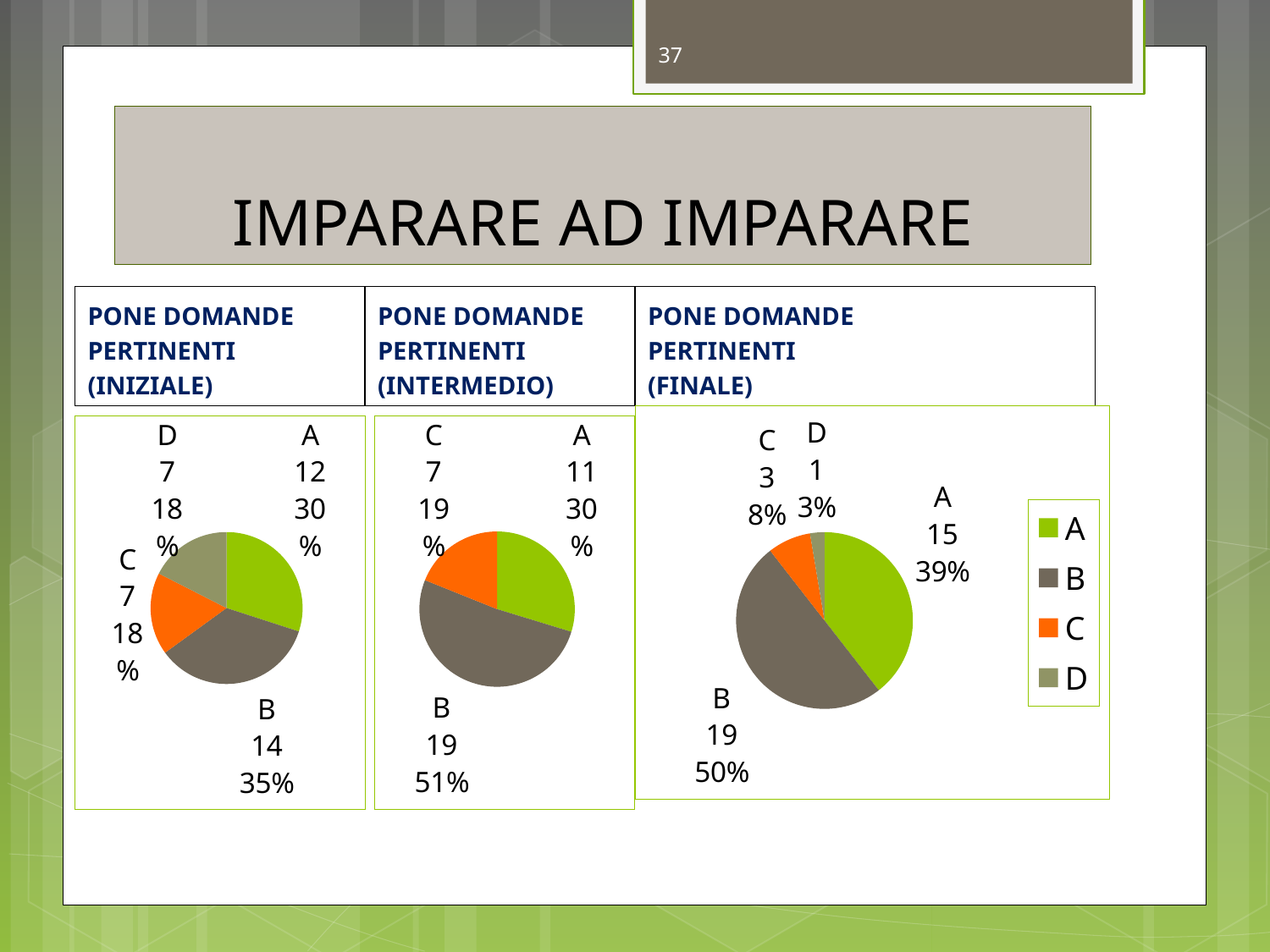
In the PONE DOMANDE PERTINENTI (FINALE) chart, which category has the smallest slice? D What type of chart is used for PONE DOMANDE PERTINENTI (FINALE)? Pie chart How many entries does the legend of the PONE DOMANDE PERTINENTI (FINALE) chart list? 4 In the PONE DOMANDE PERTINENTI (INIZIALE) chart, which category has the largest slice? B In the PONE DOMANDE PERTINENTI (INIZIALE) chart, what is the value for B? 14 In the PONE DOMANDE PERTINENTI (INTERMEDIO) chart, what is the value for B? 19 In the PONE DOMANDE PERTINENTI (INIZIALE) chart, what percentage share does A have? 30% How many slices does the PONE DOMANDE PERTINENTI (INTERMEDIO) pie chart have? 3 In the PONE DOMANDE PERTINENTI (FINALE) chart, what is the difference between the values for B and C? 16 In the PONE DOMANDE PERTINENTI (FINALE) chart, which is larger, the value for A or the value for B? B In the PONE DOMANDE PERTINENTI (INTERMEDIO) chart, what percentage share does C have? 19% In the PONE DOMANDE PERTINENTI (FINALE) chart, what is the value for A? 15